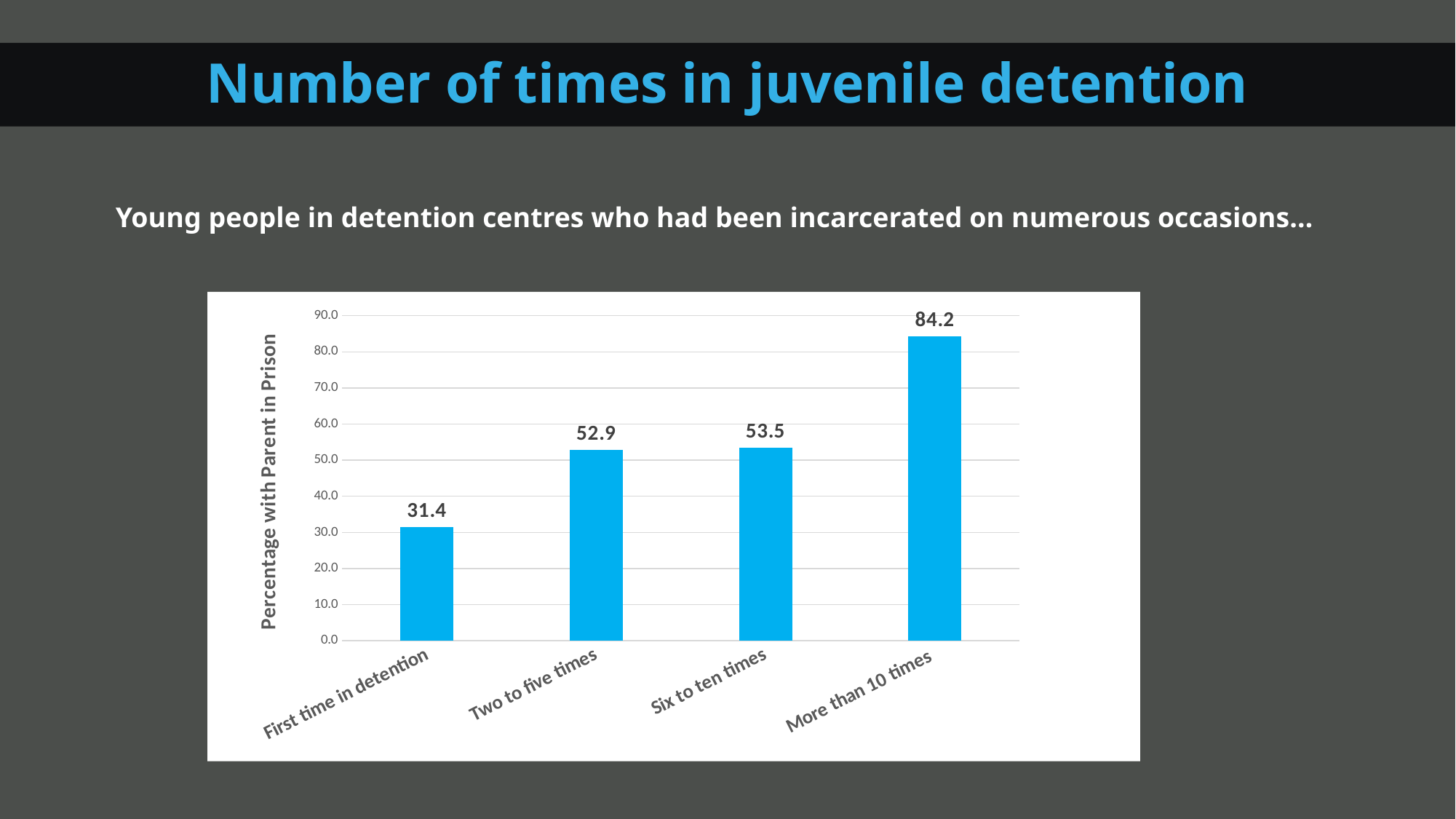
How many categories are shown on the x axis? 4 What is the difference between the values for 'Six to ten times' and 'Two to five times'? 0.6 What is the value for 'First time in detention'? 31.4 Which is larger, the value for 'Two to five times' or the value for 'More than 10 times'? More than 10 times What is the label of the vertical axis? Percentage with Parent in Prison What is the value for 'Two to five times'? 52.9 Which category has the highest value? More than 10 times Which category has the lowest value? First time in detention What is the value for 'More than 10 times'? 84.2 What is the value for 'Six to ten times'? 53.5 What is the difference between the values for 'More than 10 times' and 'First time in detention'? 52.8 What kind of chart is shown on the slide? Bar chart